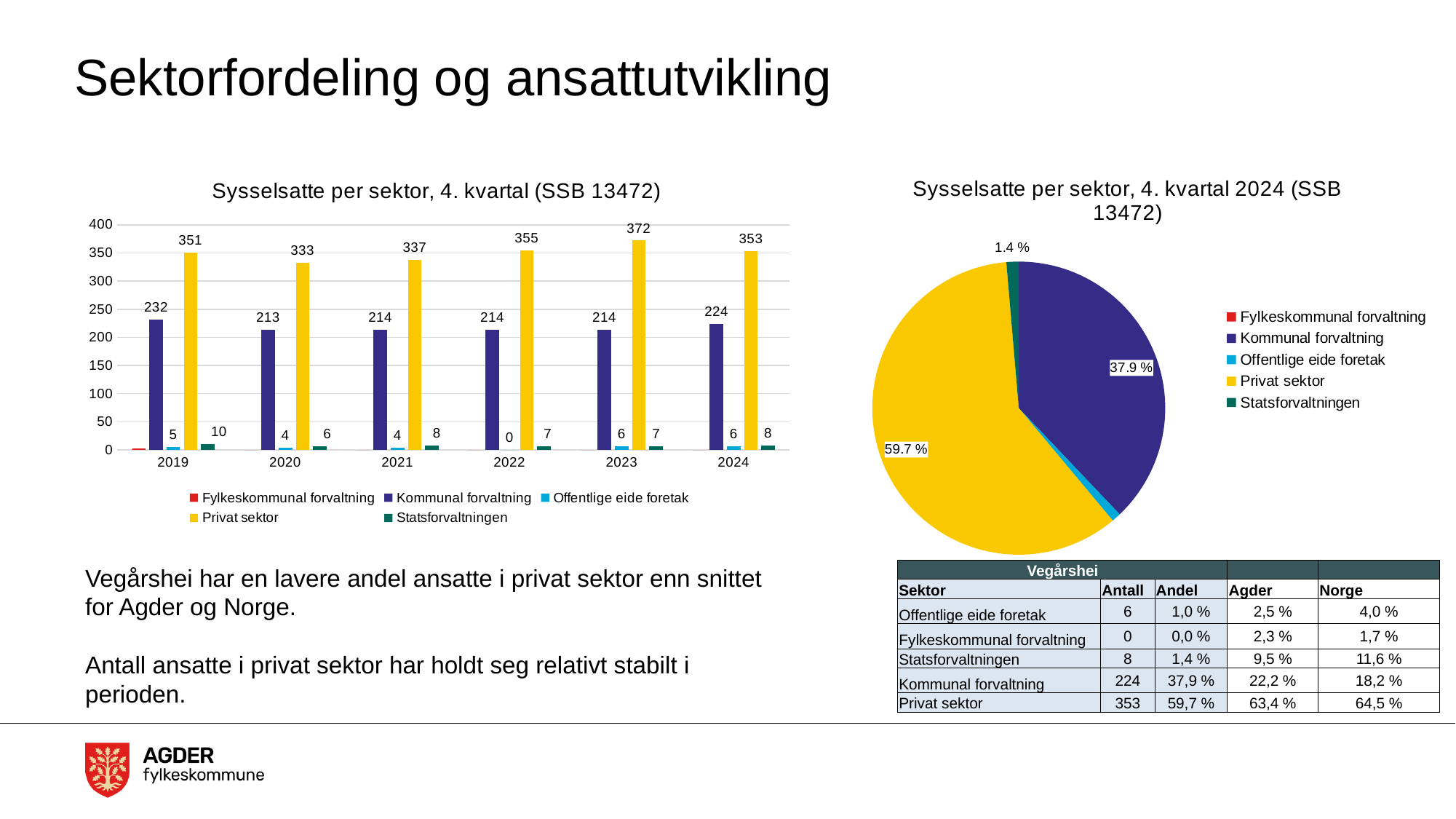
In the bar chart 'Sysselsatte per sektor, 4. kvartal (SSB 13472)', is the value for Kommunal forvaltning in 2020 greater or less than 250? less In the pie chart 'Sysselsatte per sektor, 4. kvartal 2024 (SSB 13472)', which is larger, Kommunal forvaltning or Statsforvaltningen? Kommunal forvaltning In the pie chart 'Sysselsatte per sektor, 4. kvartal 2024 (SSB 13472)', what share does Privat sektor have? 59.7 % In the bar chart 'Sysselsatte per sektor, 4. kvartal (SSB 13472)', what is the value for Kommunal forvaltning in 2019? 232 In the bar chart 'Sysselsatte per sektor, 4. kvartal (SSB 13472)', which year has the highest value for Privat sektor? 2023 In the bar chart 'Sysselsatte per sektor, 4. kvartal (SSB 13472)', which year has the lowest value for Privat sektor? 2020 In the bar chart 'Sysselsatte per sektor, 4. kvartal (SSB 13472)', how many years are shown on the x axis? 6 What kind of chart is the chart on the right of the slide, 'Sysselsatte per sektor, 4. kvartal 2024 (SSB 13472)'? Pie chart In the bar chart 'Sysselsatte per sektor, 4. kvartal (SSB 13472)', what is the value for Statsforvaltningen in 2021? 8 In the bar chart 'Sysselsatte per sektor, 4. kvartal (SSB 13472)', what is the value for Privat sektor in 2023? 372 In the bar chart 'Sysselsatte per sektor, 4. kvartal (SSB 13472)', how many series does the legend list? 5 In the bar chart 'Sysselsatte per sektor, 4. kvartal (SSB 13472)', what is the difference between Privat sektor and Kommunal forvaltning in 2024? 129